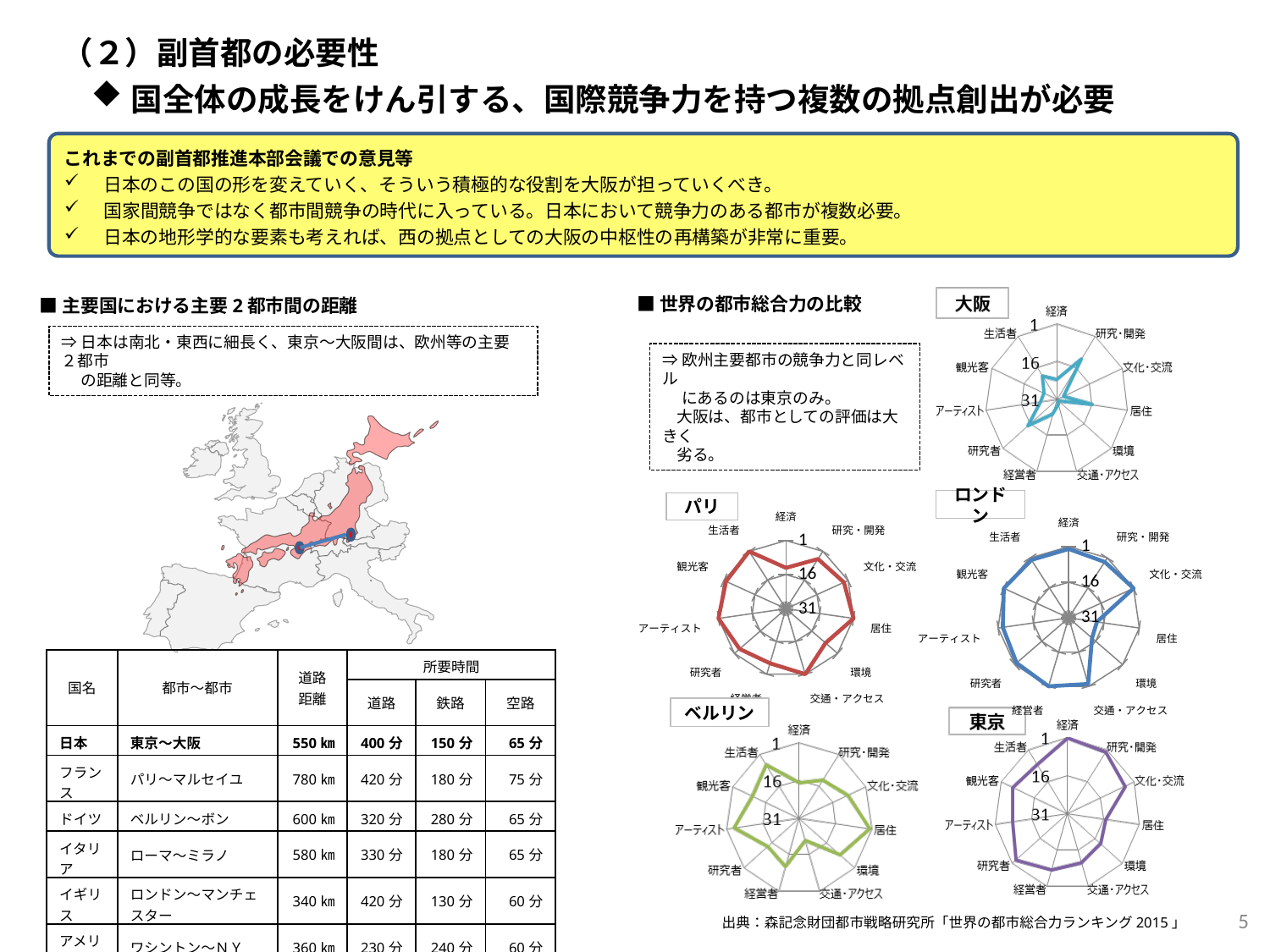
How many axes (categories) does the パリ radar chart have? 11 In the パリ radar chart, is the value for 経済 greater or less than 16? less What are the three tick values printed on the axis of the パリ radar chart? 1, 16, 31 How many radar charts are shown in the 世界の都市総合力の比較 section? 5 In the ロンドン radar chart, is the value for 文化・交流 greater or less than 16? less Which city's radar chart is drawn in purple? 東京 In the ベルリン radar chart, is the value for 居住 greater or less than 16? less Which city's radar chart is drawn in green? ベルリン What kind of chart is used for the 大阪 chart in the 世界の都市総合力の比較 section? radar chart